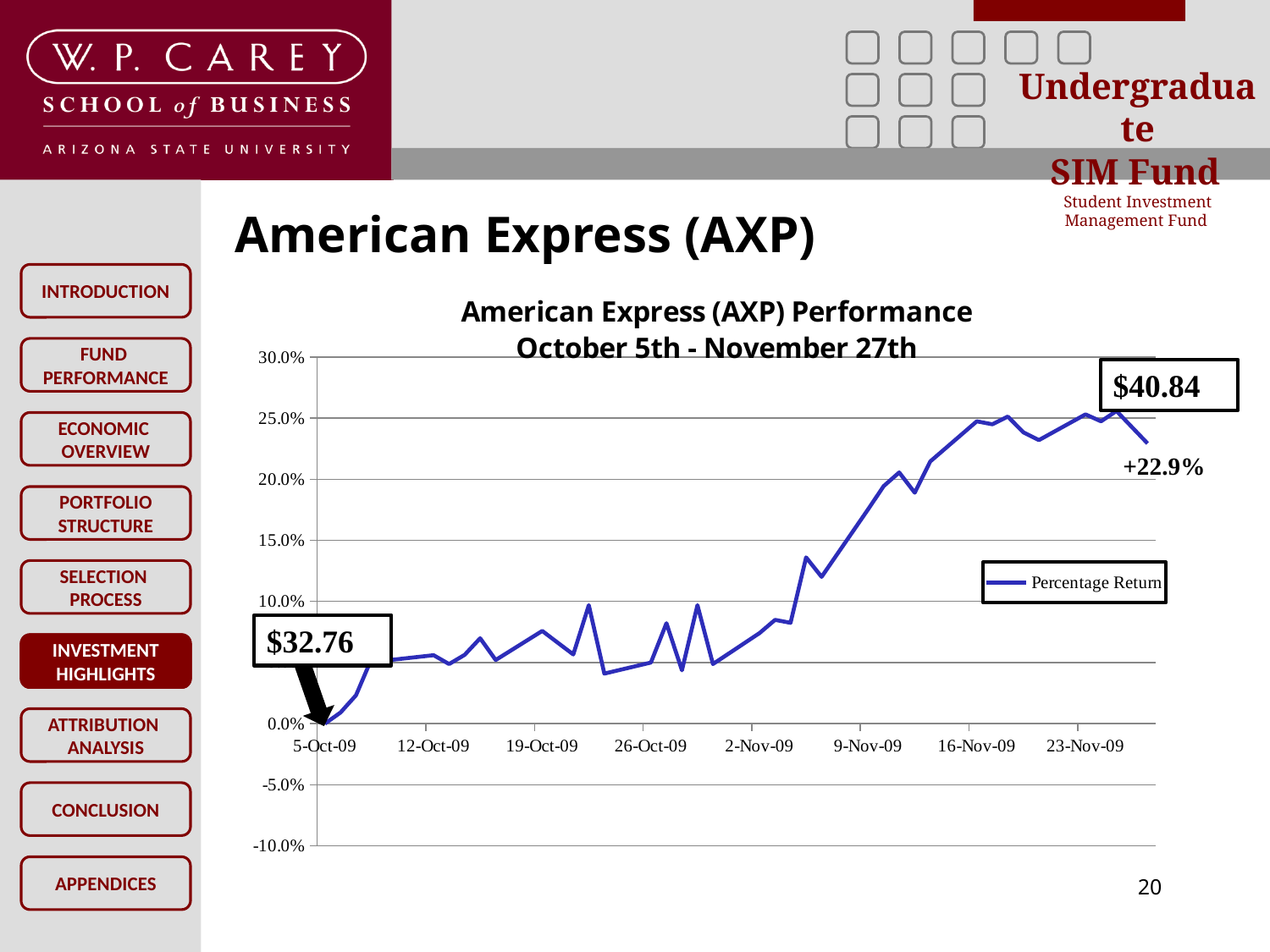
How many date labels are shown on the x axis? 8 Is the percentage return at 12-Oct-09 greater or less than 10.0%? less What starting price is annotated at the beginning of the line? $32.76 What ending price is annotated at the end of the line? $40.84 What is the name of the series shown in the chart legend? Percentage Return Overall, does the percentage return rise or fall from 5-Oct-09 to the end of the period? rise Is the percentage return at 16-Nov-09 greater or less than 20.0%? greater How many series does the chart legend list? 1 What date range is given in the chart title? October 5th - November 27th What kind of chart is shown on the slide? line chart What overall percentage return is annotated on the chart? +22.9% Is the percentage return at 9-Nov-09 greater or less than 10.0%? greater